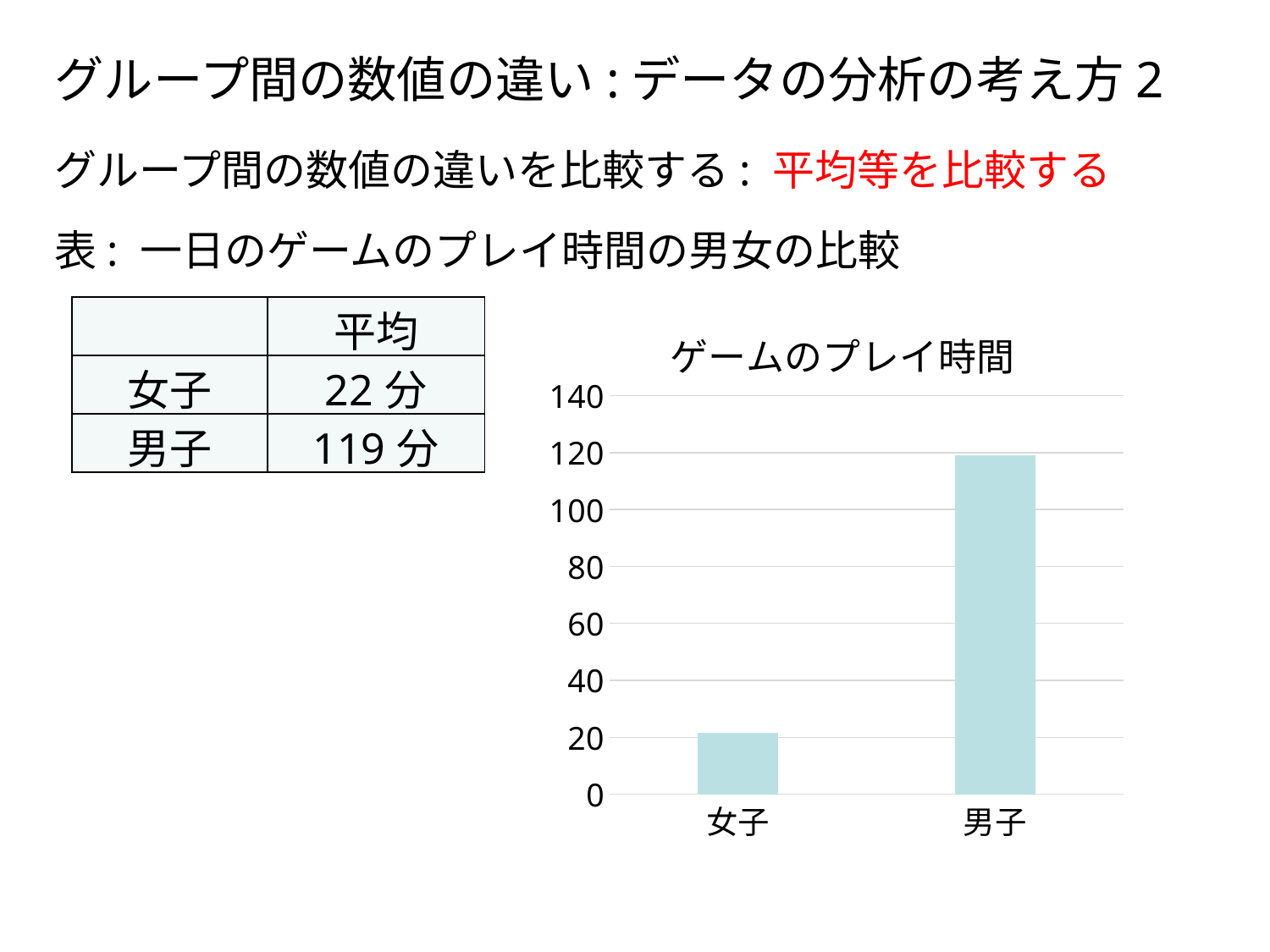
According to the table on the slide, what is the average game play time for 女子? 22 分 What type of chart is shown on the slide? bar chart Which category has the lowest bar in the chart? 女子 Which is larger, the bar for 女子 or the bar for 男子? 男子 What is the title of the chart? ゲームのプレイ時間 Is the bar for 男子 greater or less than 140? less Which category has the highest bar in the chart? 男子 According to the table on the slide, what is the average game play time for 男子? 119 分 How many categories are shown on the x axis of the chart? 2 Is the bar for 男子 greater or less than 100? greater Using the values in the table, what is the difference between the average play time of 男子 and 女子? 97 分 Is the bar for 女子 greater or less than 40? less